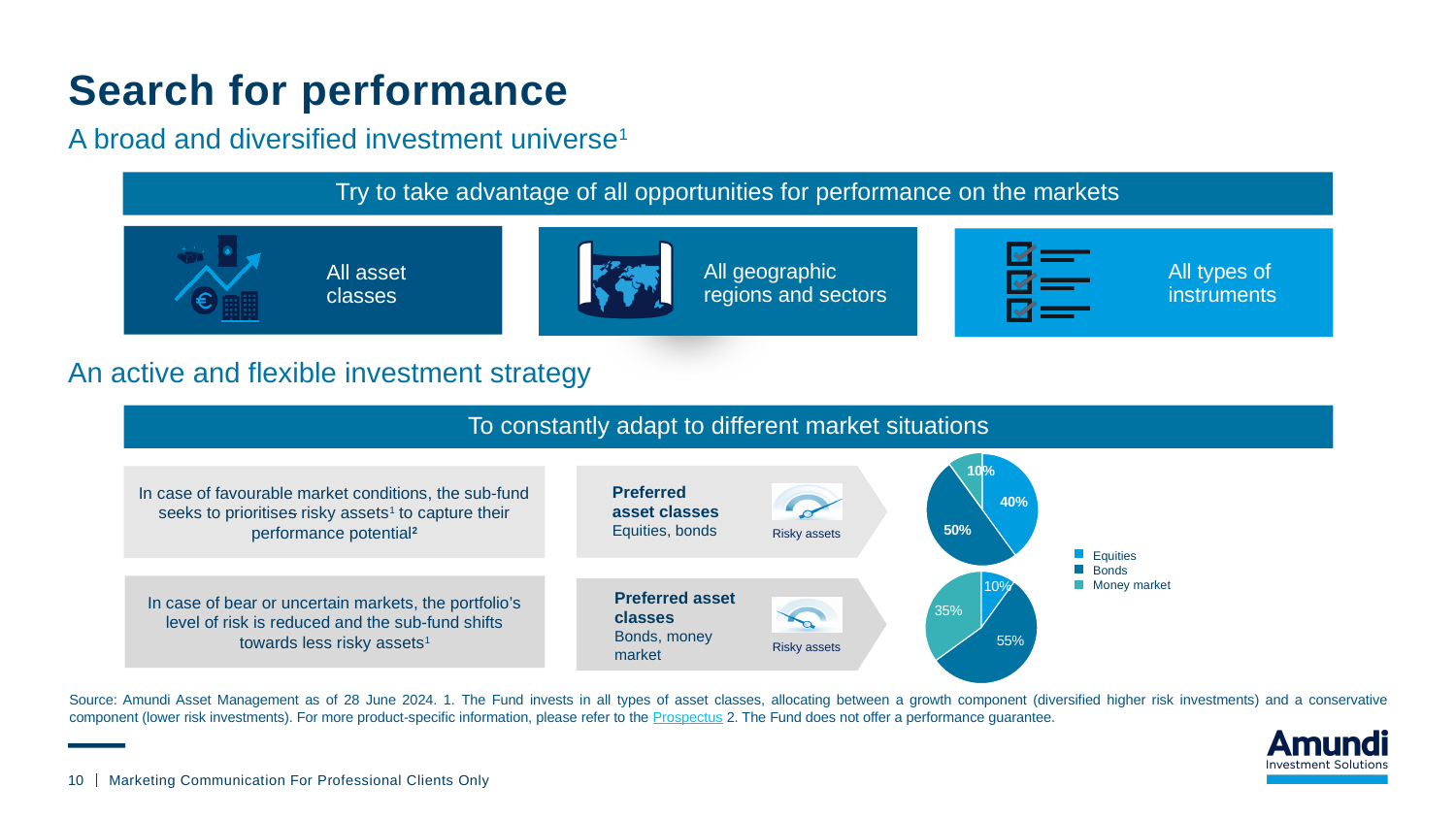
In the top pie chart (favourable market conditions), what is the smallest slice's value? 10% In the bottom pie chart (bear or uncertain markets), what is the smallest slice's value? 10% In the bottom pie chart (bear or uncertain markets), what share is allocated to Money market? 35% How many pie charts are shown on the slide? 2 Which legend entry is shown in the darkest blue colour? Equities In the bottom pie chart (bear or uncertain markets), what is the largest slice's value? 55% In the top pie chart (favourable market conditions), what share is allocated to Equities? 40% In the top pie chart (favourable market conditions), what share is allocated to Bonds? 50% What kind of chart is used to show the asset allocations on the right of the slide? Pie chart How many entries does the legend next to the pie charts list? 3 In the bottom pie chart (bear or uncertain markets), what is the difference between the largest slice (55%) and the smallest slice (10%)? 45% In the top pie chart (favourable market conditions), what is the largest slice's value? 50%